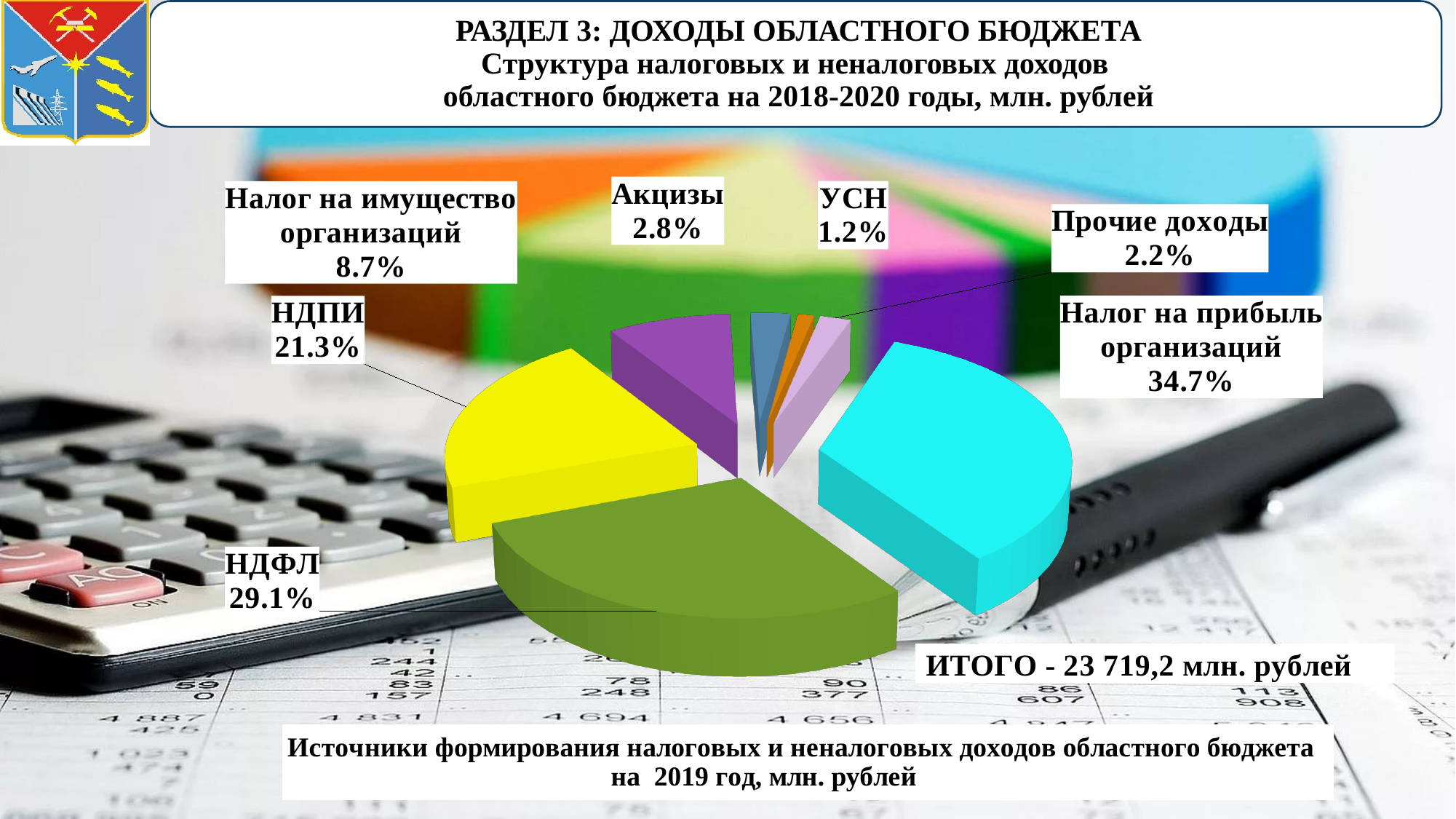
What kind of chart is shown on the slide? pie chart What share of the pie does Налог на имущество организаций have? 8.7% What share of the pie does Налог на прибыль организаций have? 34.7% What share of the pie does УСН have? 1.2% How many categories are shown in the pie chart? 7 Which category has the largest share of the pie? Налог на прибыль организаций What total amount (ИТОГО) is stated next to the pie chart? 23 719,2 млн. рублей Which category has the smallest share of the pie? УСН Which has a larger share, Акцизы or Прочие доходы? Акцизы What is the difference in percentage points between the shares of Налог на прибыль организаций and НДФЛ? 5.6